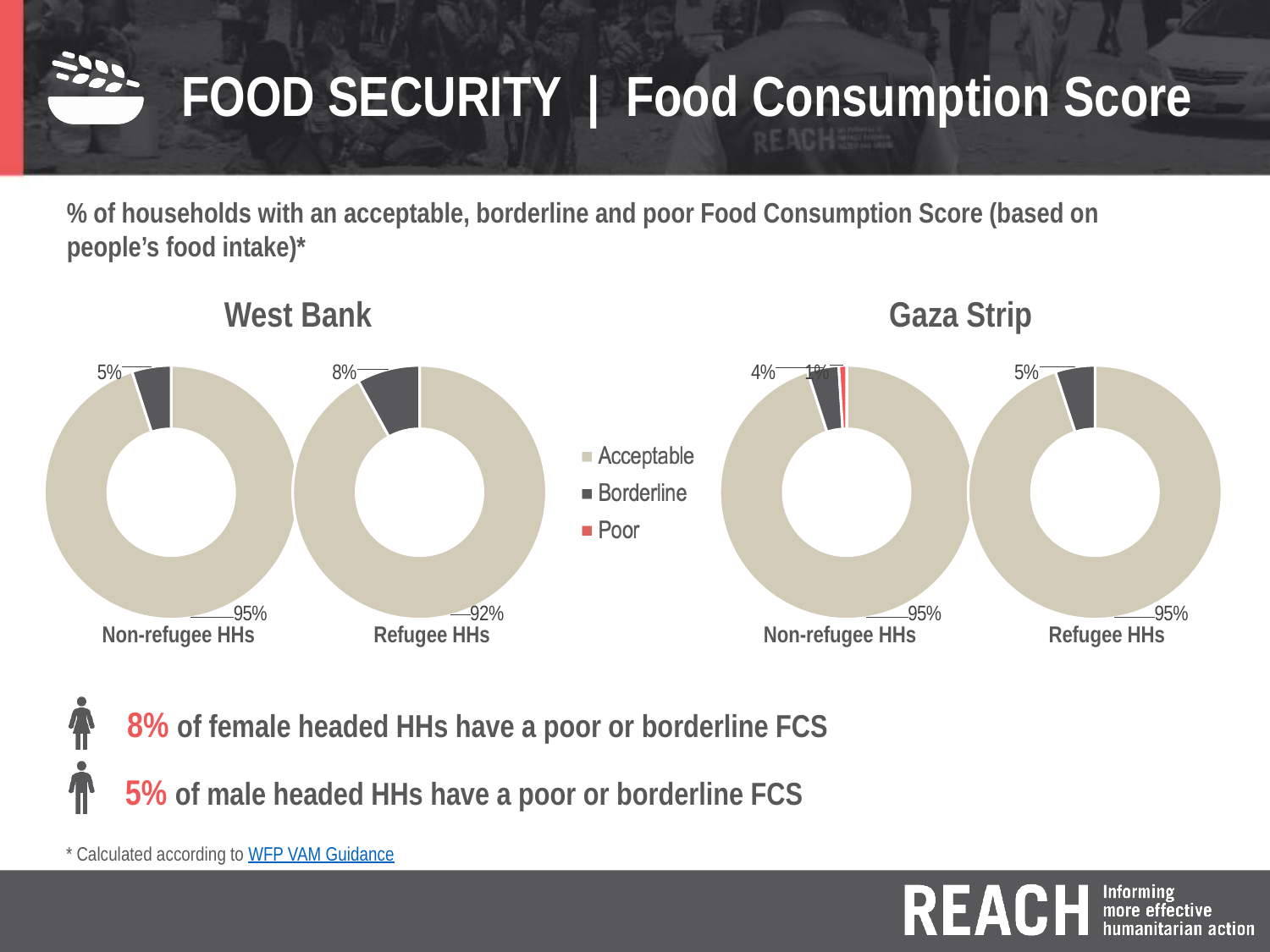
In the West Bank Refugee HHs chart, what is the difference between the acceptable and borderline shares? 84% In the West Bank Non-refugee HHs chart, which category has the largest share? Acceptable How many entries does the legend list for the Food Consumption Score charts? 3 In the West Bank Refugee HHs chart, what percentage of households have a borderline Food Consumption Score? 8% In the West Bank Non-refugee HHs chart, what percentage of households have an acceptable Food Consumption Score? 95% Which colour represents the Poor category in the legend? Red In the Gaza Strip Non-refugee HHs chart, which category has the smallest share? Poor Which has a larger borderline share: West Bank Non-refugee HHs or West Bank Refugee HHs? West Bank Refugee HHs What kind of chart is used to show the Food Consumption Score for each household group? Donut (pie) chart In the Gaza Strip Refugee HHs chart, what percentage of households have a borderline Food Consumption Score? 5% How many donut charts are shown on the slide? 4 In the Gaza Strip Non-refugee HHs chart, what percentage of households have a poor Food Consumption Score? 1%